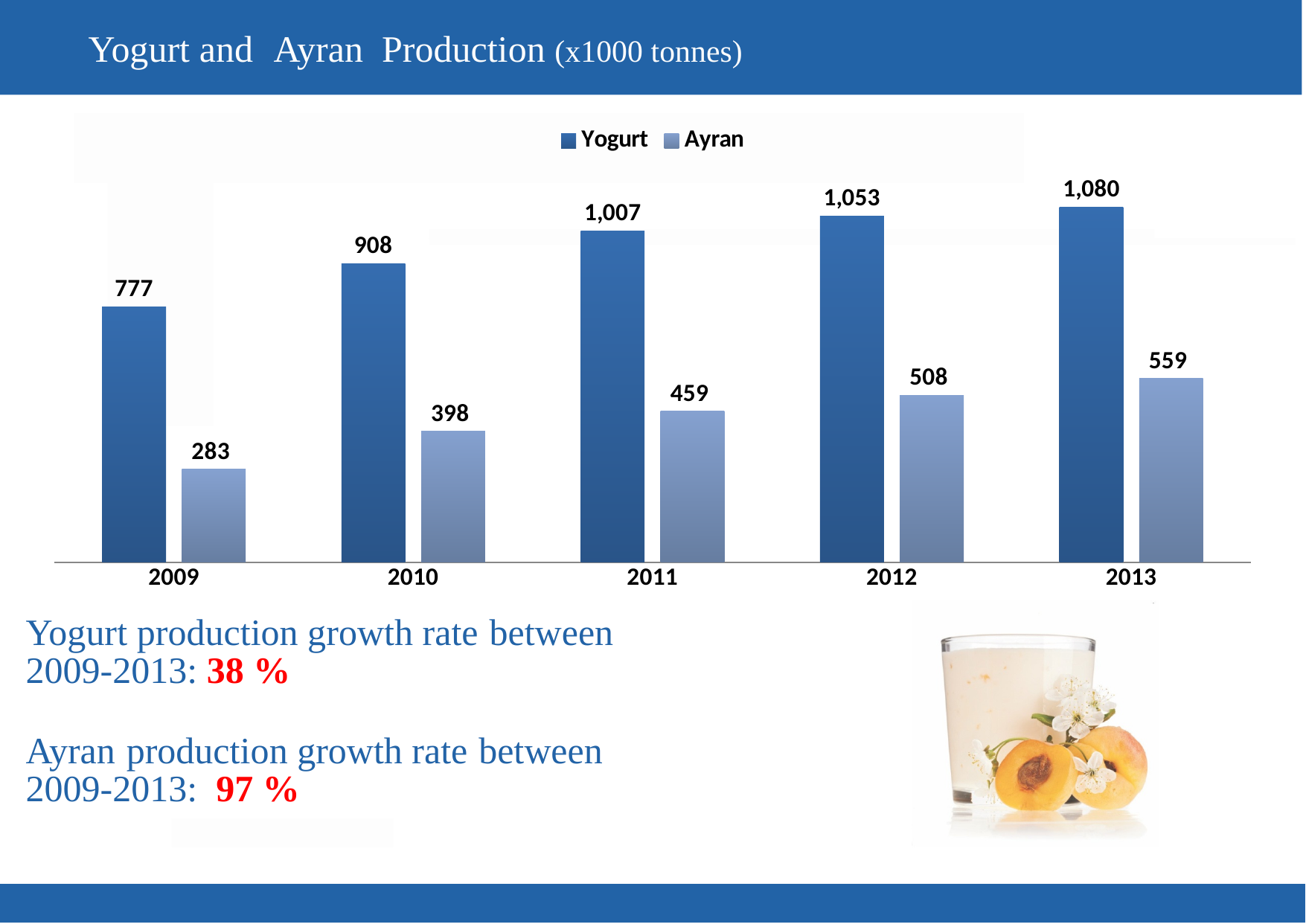
What was Ayran production in 2009? 283 What was Yogurt production in 2011? 1,007 What kind of chart is shown on the slide? Bar chart What is the difference between Yogurt and Ayran production in 2013? 521 How many years are shown on the x axis? 5 In which year was Ayran production lowest? 2009 In which year was Yogurt production highest? 2013 How much did Yogurt production increase from 2009 to 2010? 131 Does Ayran production rise or fall from 2009 to 2013? Rise Which was larger in 2010: Yogurt production or Ayran production? Yogurt How many series does the legend list? 2 What was Ayran production in 2012? 508